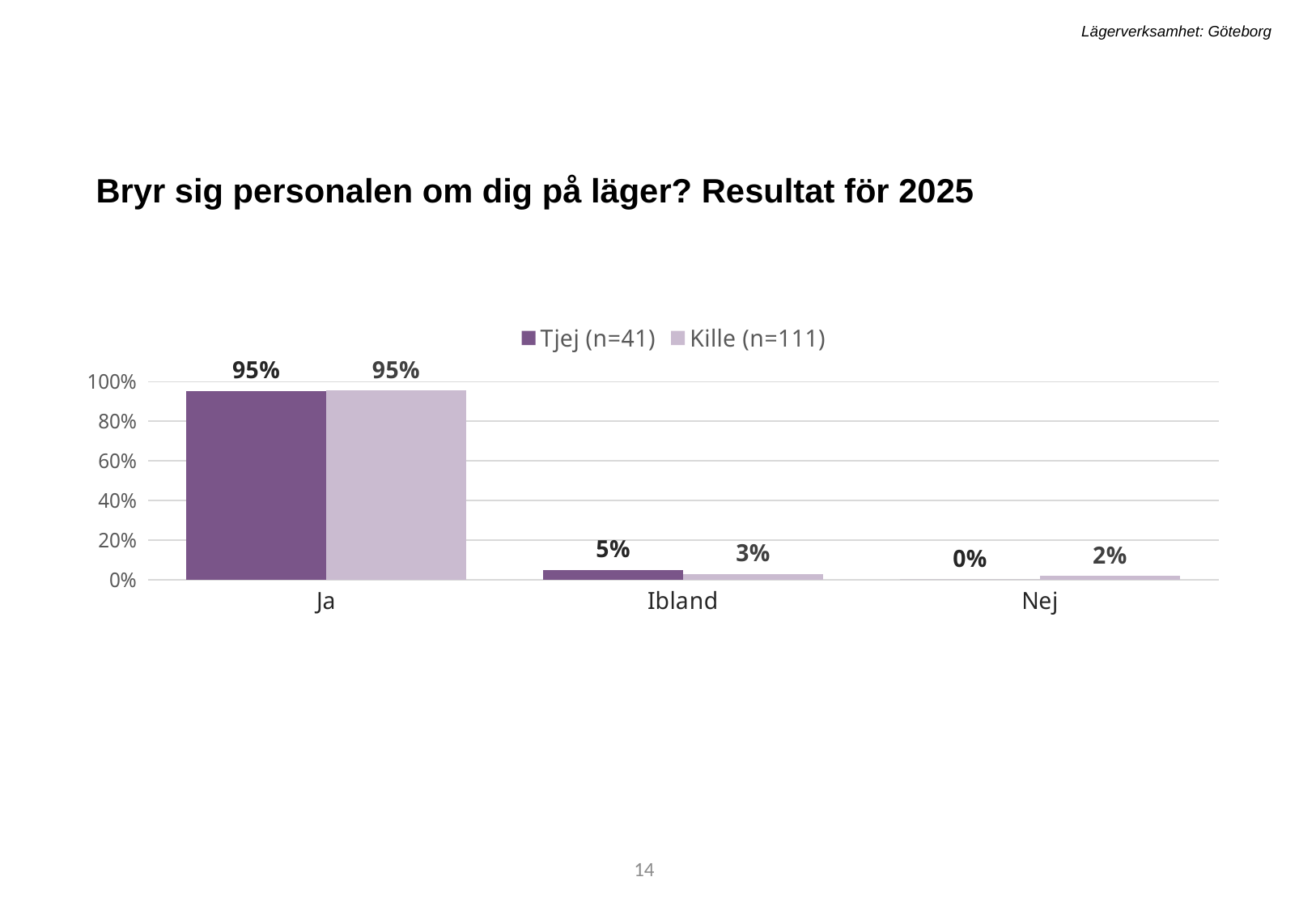
How many series does the legend list? 2 Is the value for Tjej (n=41) in the Ja category greater or less than 80%? greater Which category has the highest value for Kille (n=111)? Ja What kind of chart is shown on the slide? bar chart What is the value for Kille (n=111) in the Nej category? 2% What is the value for Tjej (n=41) in the Nej category? 0% Which category has the lowest value for Tjej (n=41)? Nej In the Nej category, which series has the larger value, Tjej (n=41) or Kille (n=111)? Kille (n=111) What is the difference between the Tjej (n=41) and Kille (n=111) values in the Ibland category? 2% What is the value for Tjej (n=41) in the Ja category? 95% How many categories are shown on the x axis? 3 What is the value for Kille (n=111) in the Ibland category? 3%